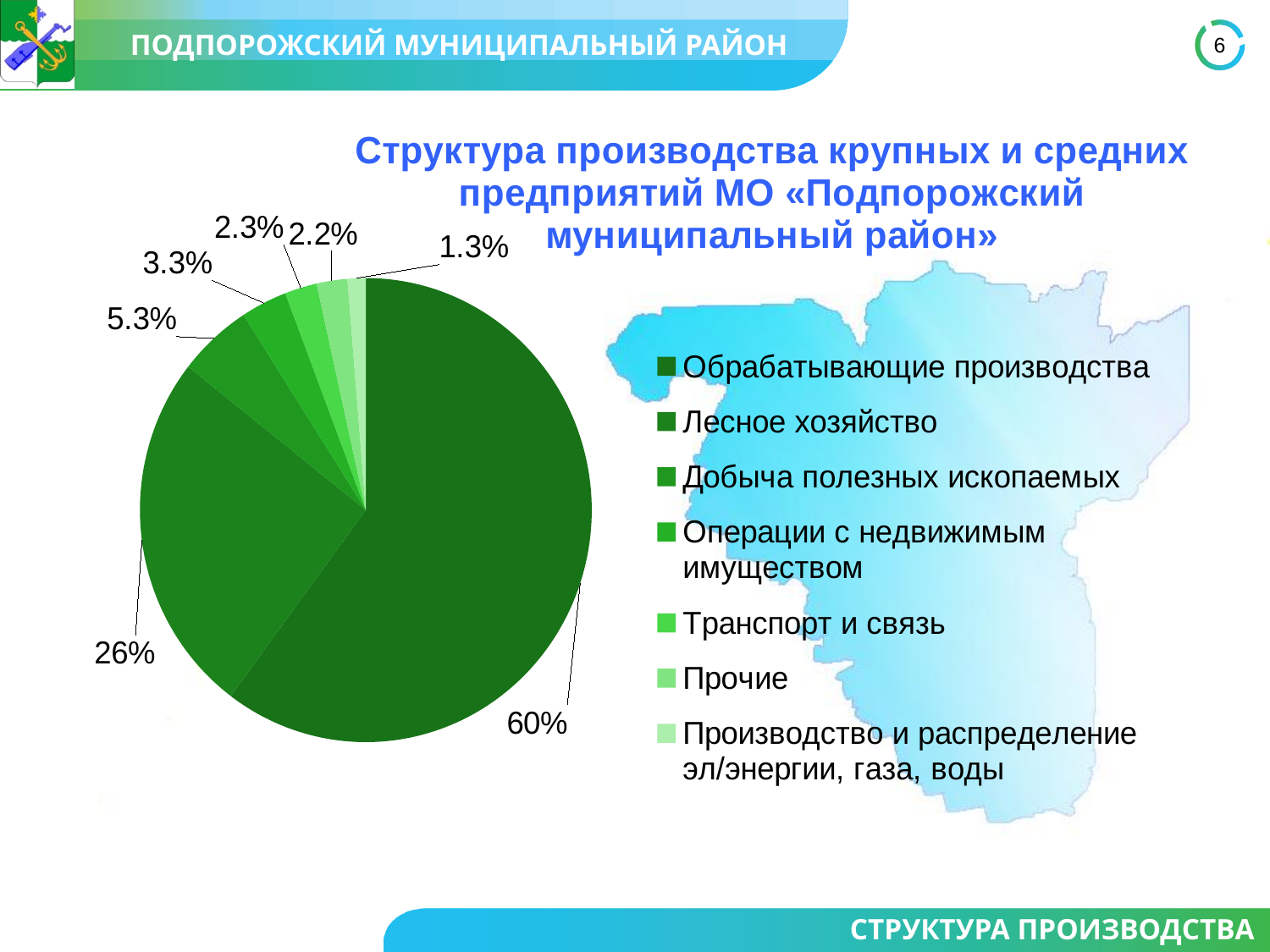
What share of production does Добыча полезных ископаемых account for? 5.3% Which category has the largest share of the pie? Обрабатывающие производства What share of production does Производство и распределение эл/энергии, газа, воды account for? 1.3% What type of chart is shown on the slide? Pie chart What is the difference in share between Обрабатывающие производства and Лесное хозяйство? 34% What share of production does Транспорт и связь account for? 2.3% What share of production does Лесное хозяйство account for? 26% What is the title of the chart? Структура производства крупных и средних предприятий МО «Подпорожский муниципальный район» Which category has the smallest share of the pie? Производство и распределение эл/энергии, газа, воды What share of production do Обрабатывающие производства account for? 60% Which has a larger share: Добыча полезных ископаемых or Операции с недвижимым имуществом? Добыча полезных ископаемых How many categories does the legend list? 7